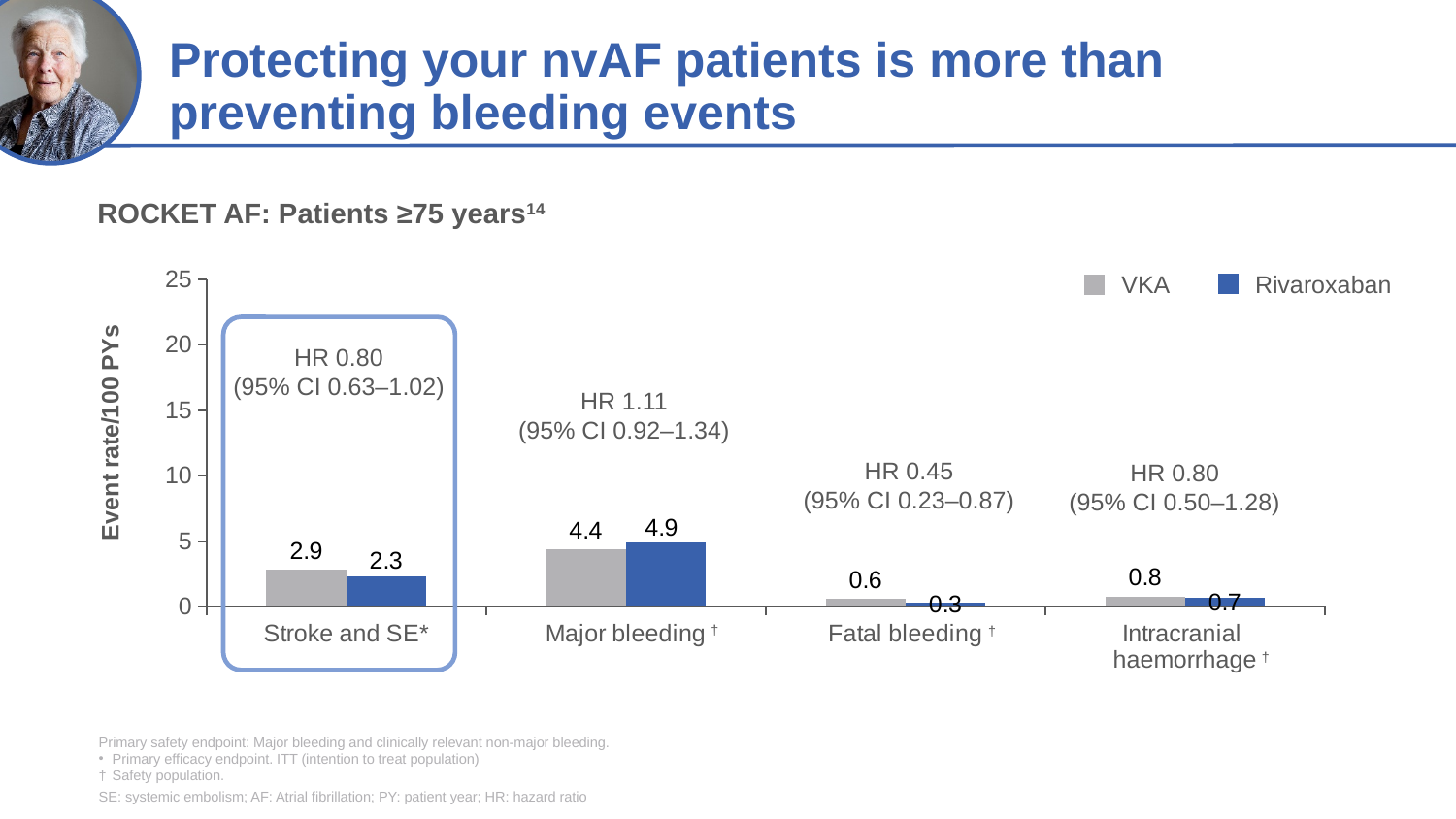
How many categories are shown on the x axis? 4 What is the Rivaroxaban event rate for Major bleeding? 4.9 What is the Rivaroxaban event rate for Fatal bleeding? 0.3 What is the VKA event rate for Intracranial haemorrhage? 0.8 Is the VKA event rate for Major bleeding greater or less than 5? less How many series does the legend list? 2 What kind of chart is shown on the slide? bar chart Which category has the highest Rivaroxaban event rate? Major bleeding Which category has the lowest VKA event rate? Fatal bleeding For Major bleeding, which series has the larger event rate, VKA or Rivaroxaban? Rivaroxaban What is the VKA event rate for Stroke and SE? 2.9 What is the difference between the VKA and Rivaroxaban event rates for Stroke and SE? 0.6